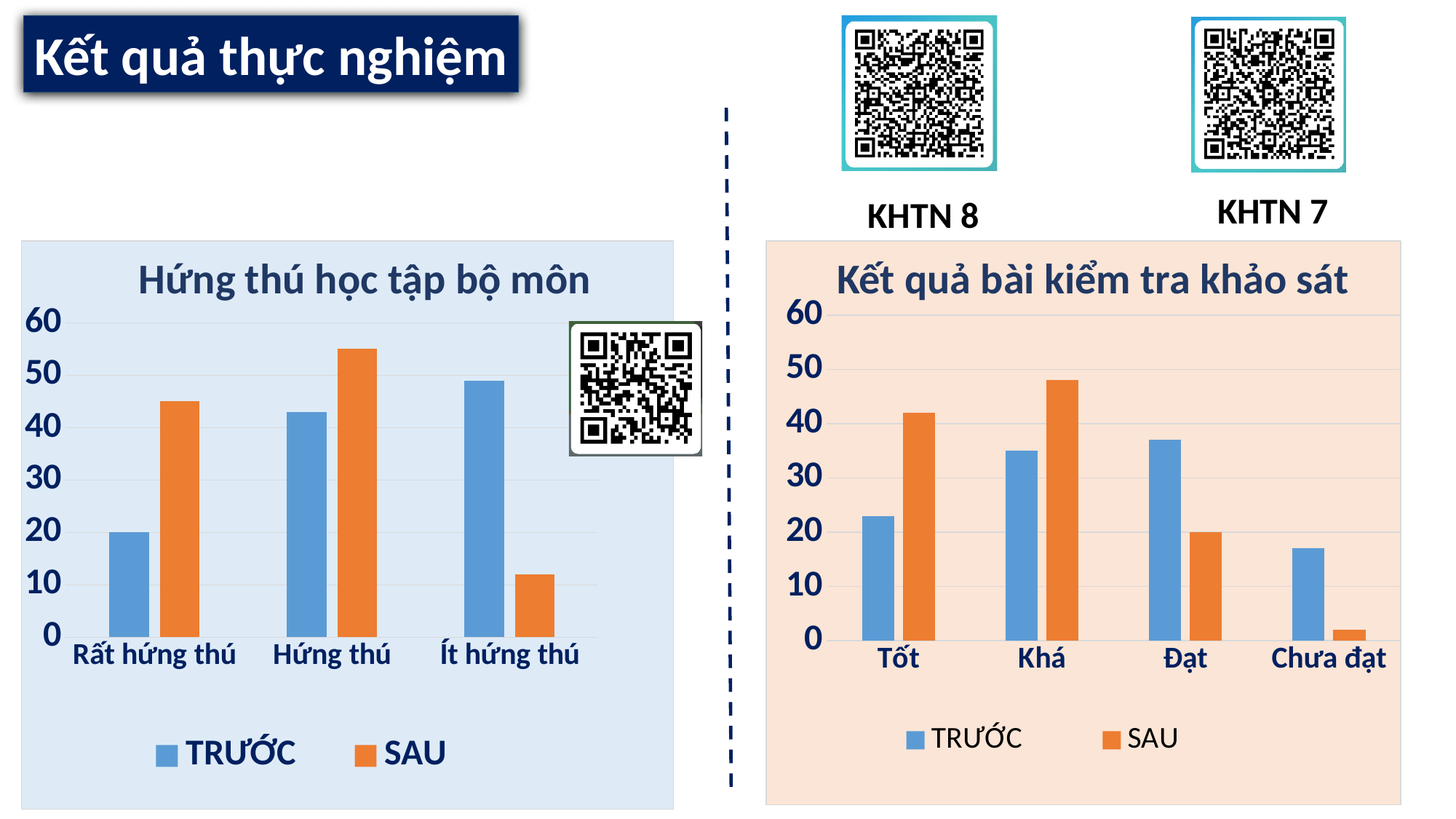
In the chart titled "Kết quả bài kiểm tra khảo sát", how many categories are shown on the x axis? 4 In the chart titled "Hứng thú học tập bộ môn", how many categories are shown on the x axis? 3 In the chart titled "Hứng thú học tập bộ môn", is the SAU value for Ít hứng thú greater or less than 20? less In the chart titled "Kết quả bài kiểm tra khảo sát", which category has the lowest SAU value? Chưa đạt In the chart titled "Hứng thú học tập bộ môn", which category has the highest SAU value? Hứng thú In the chart titled "Kết quả bài kiểm tra khảo sát", which category has the highest SAU value? Khá In the chart titled "Kết quả bài kiểm tra khảo sát", for Đạt, which series is larger, TRƯỚC or SAU? TRƯỚC In the chart titled "Hứng thú học tập bộ môn", for Rất hứng thú, which series is larger, TRƯỚC or SAU? SAU In the chart titled "Hứng thú học tập bộ môn", how many series does the legend list? 2 In the chart titled "Hứng thú học tập bộ môn", what kind of chart is shown? bar chart In the chart titled "Kết quả bài kiểm tra khảo sát", is the TRƯỚC value for Tốt greater or less than 30? less In the chart titled "Kết quả bài kiểm tra khảo sát", what colour are the SAU bars? orange